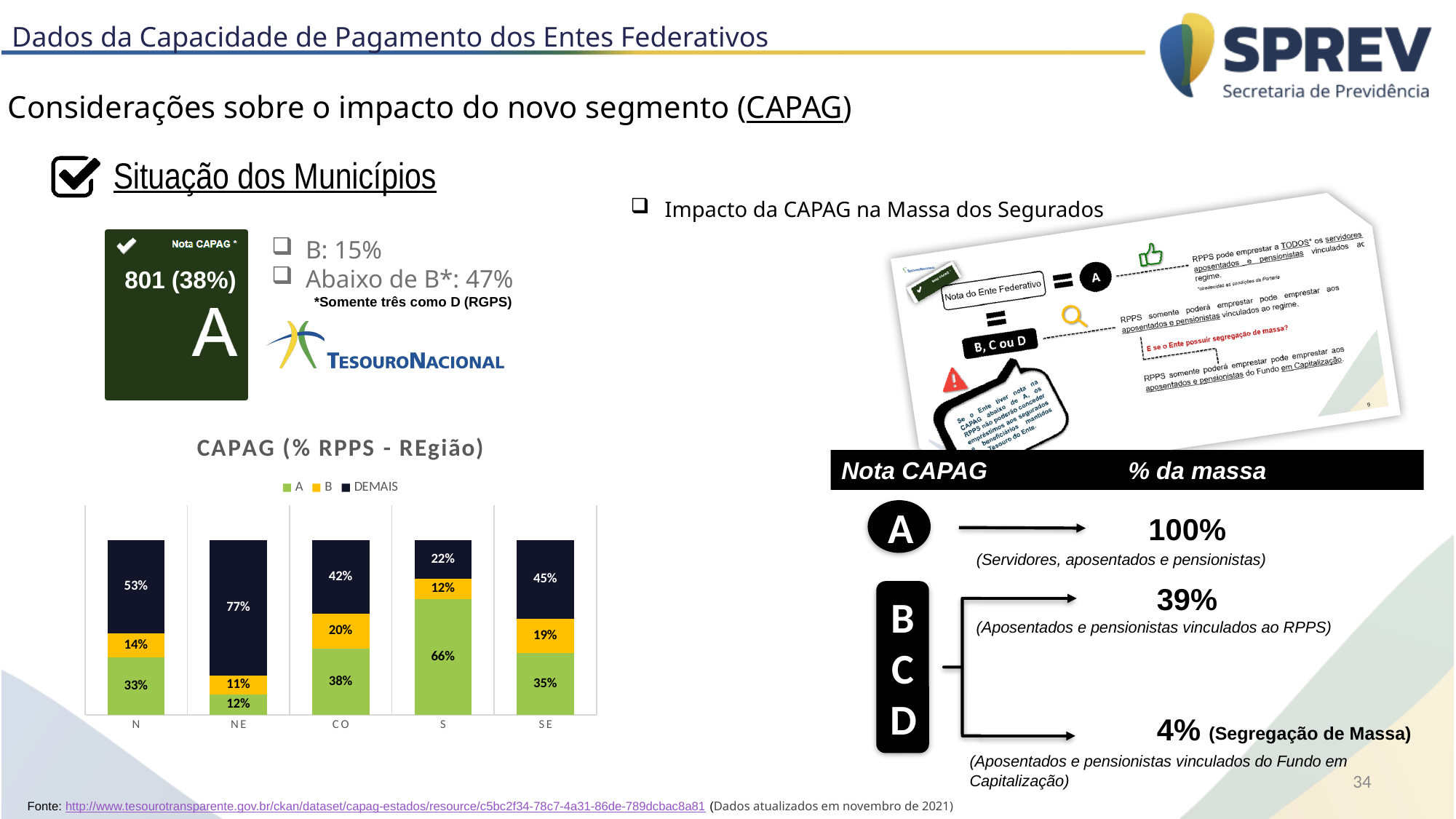
In the CAPAG (% RPPS - REgião) chart, which region has the lowest value for DEMAIS? S In the CAPAG (% RPPS - REgião) chart, what is the value of series A for region S? 66% In the CAPAG (% RPPS - REgião) chart, which is larger: series A for N or series A for SE? SE In the CAPAG (% RPPS - REgião) chart, what is the total of the stacked bar for region N? 100% In the CAPAG (% RPPS - REgião) chart, what is the difference between the DEMAIS values for NE and CO? 35% How many series does the legend of the CAPAG (% RPPS - REgião) chart list? 3 In the CAPAG (% RPPS - REgião) chart, what is the value of DEMAIS for region NE? 77% In the CAPAG (% RPPS - REgião) chart, which region has the highest value for series A? S How many regions are shown on the x axis of the CAPAG (% RPPS - REgião) chart? 5 What is the title of the chart on the slide? CAPAG (% RPPS - REgião) What kind of chart is the CAPAG (% RPPS - REgião) chart? stacked bar chart In the CAPAG (% RPPS - REgião) chart, what is the value of series B for region CO? 20%